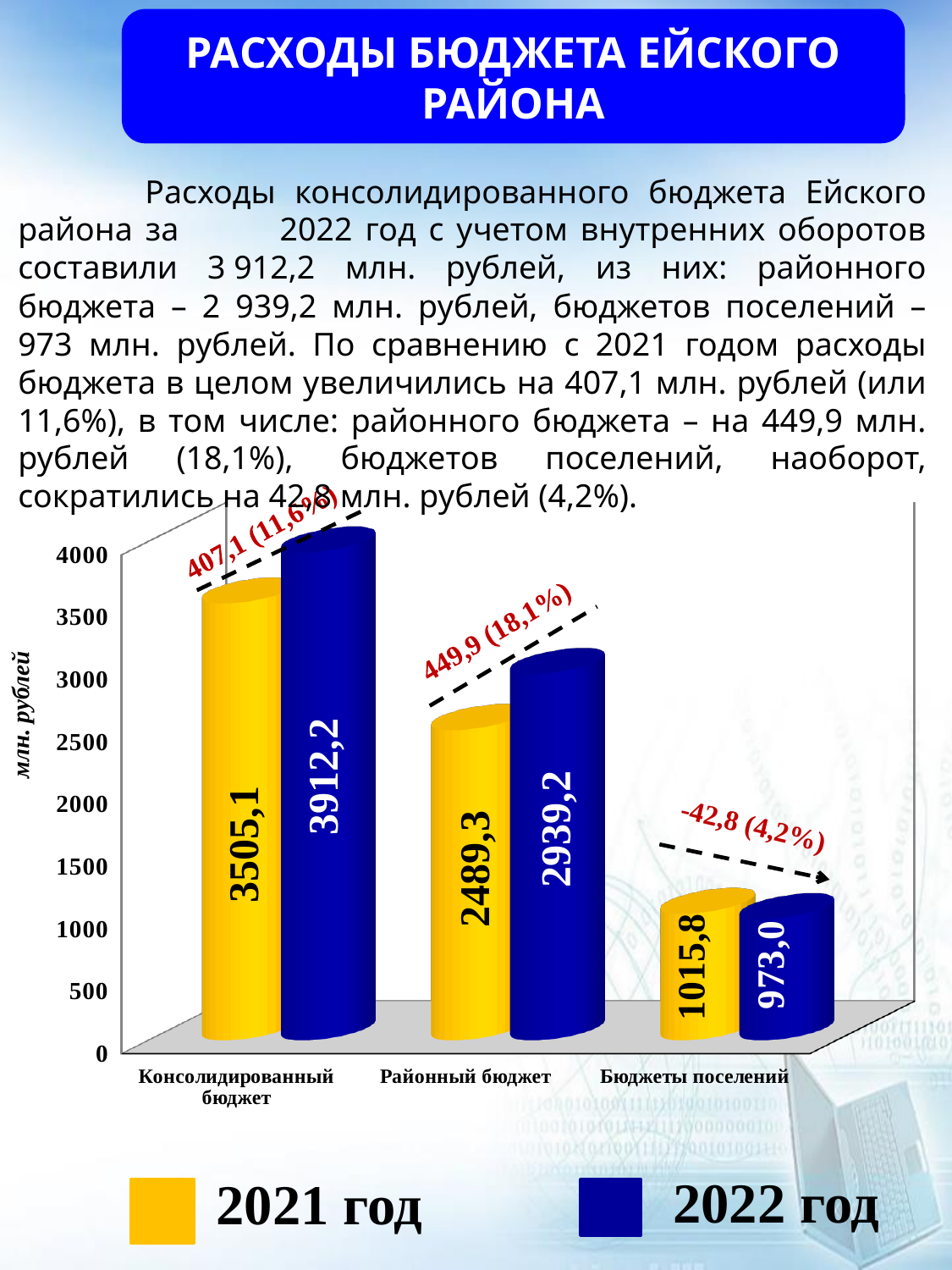
Which category has the lowest value in 2021 год? Бюджеты поселений How many categories are shown on the x axis of the chart? 3 What is the difference between the 2022 год and 2021 год values for Консолидированный бюджет? 407,1 What unit is shown on the vertical axis of the chart? млн. рублей Which category has the highest value in 2022 год? Консолидированный бюджет What is the value for Консолидированный бюджет in 2022 год? 3912,2 What kind of chart is shown on the slide? bar chart What is the value for Районный бюджет in 2021 год? 2489,3 What is the value for Бюджеты поселений in 2022 год? 973,0 Which is larger for Бюджеты поселений: the 2021 год value or the 2022 год value? 2021 год Is the value for Районный бюджет in 2022 год greater or less than 2500? greater How many series does the legend list? 2